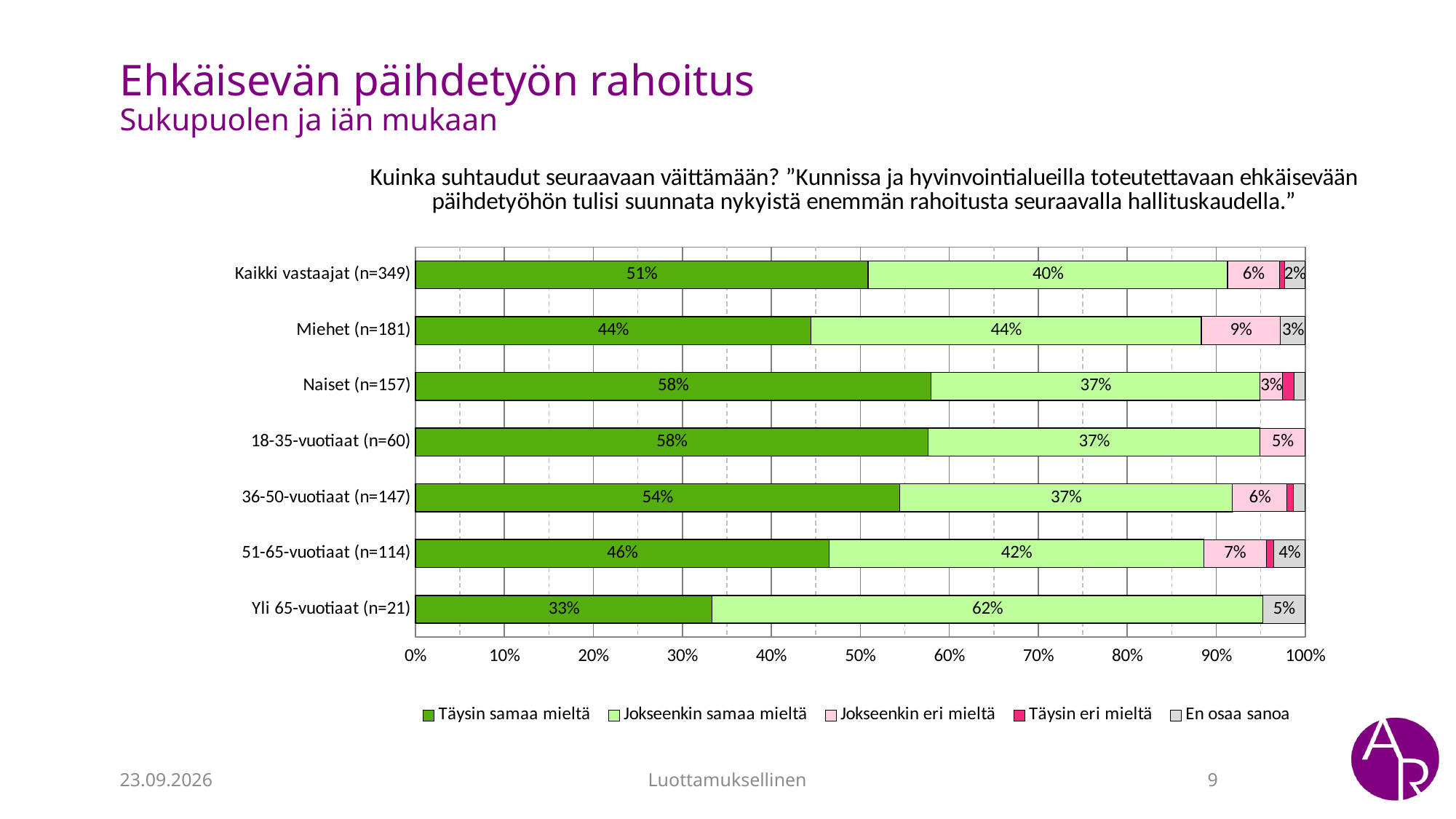
What is the En osaa sanoa value for 51-65-vuotiaat (n=114)? 4% What kind of chart is shown on the slide? Stacked bar chart How many respondent groups are shown on the chart? 7 How many series does the legend list? 5 What is the Jokseenkin eri mieltä value for Miehet (n=181)? 9% What is the difference in Täysin samaa mieltä between Naiset (n=157) and Miehet (n=181)? 14 percentage points What percentage of Kaikki vastaajat (n=349) answered Täysin samaa mieltä? 51% Which group has the lowest Täysin samaa mieltä share? Yli 65-vuotiaat (n=21) Is the Täysin samaa mieltä value for Yli 65-vuotiaat (n=21) greater or less than 40%? less Which group has the highest Jokseenkin samaa mieltä share? Yli 65-vuotiaat (n=21) Which has a larger Täysin samaa mieltä share, 36-50-vuotiaat (n=147) or 51-65-vuotiaat (n=114)? 36-50-vuotiaat (n=147) What is the Jokseenkin samaa mieltä value for Yli 65-vuotiaat (n=21)? 62%